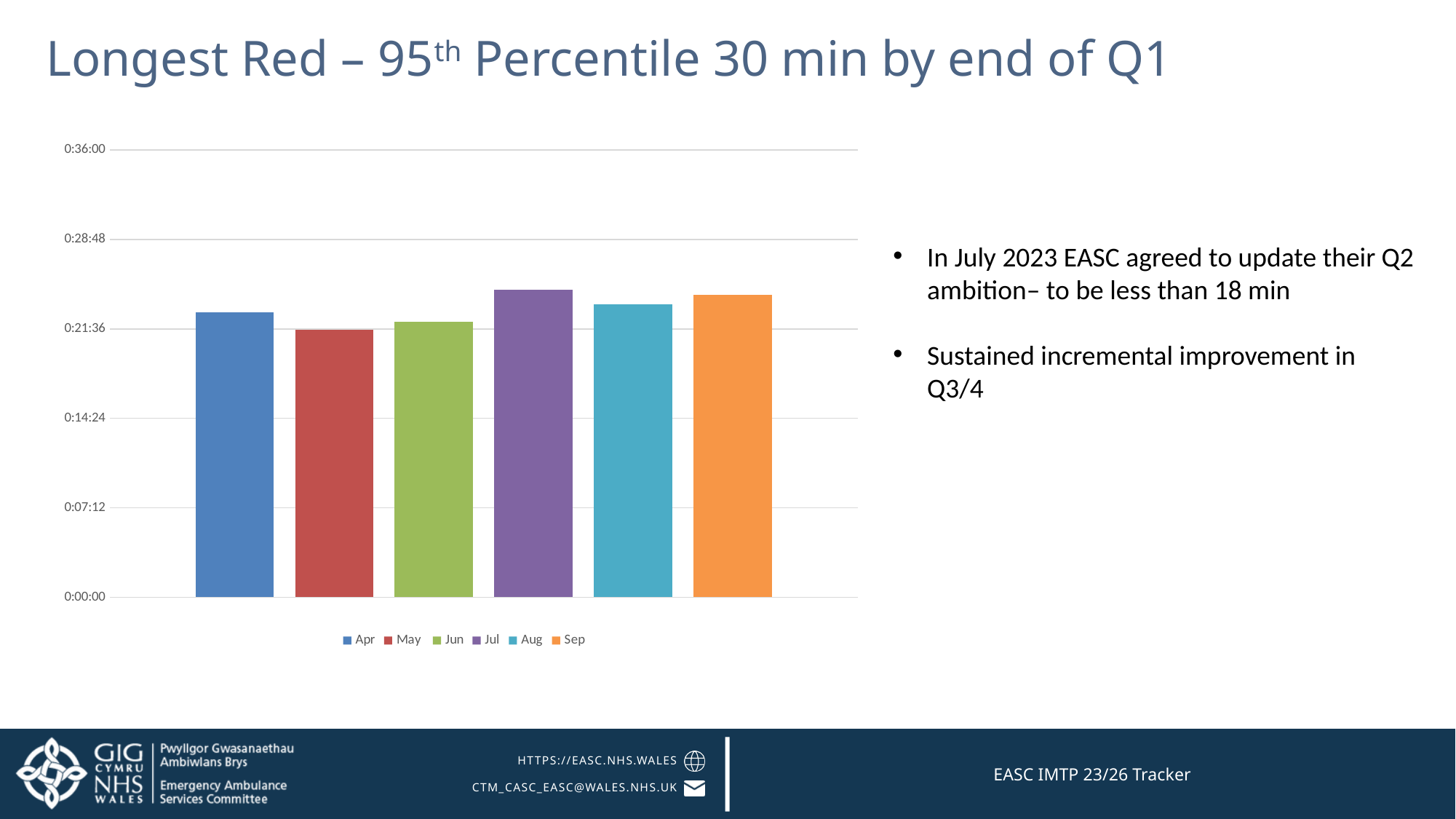
Is the value for Aug greater or less than 0:21:36? greater How many entries does the chart legend list? 6 What colour is the bar for Jul in the chart? purple What kind of chart is shown on the slide? bar chart How many bars are plotted in the chart? 6 Which is larger, the value for Jul or the value for May? Jul Is the value for Sep greater or less than 0:28:48? less What is the title of the slide containing the chart? Longest Red – 95th Percentile 30 min by end of Q1 Which month has the lowest bar in the chart? May Is the value for Jul greater or less than 0:28:48? less Which is larger, the value for Sep or the value for Jun? Sep